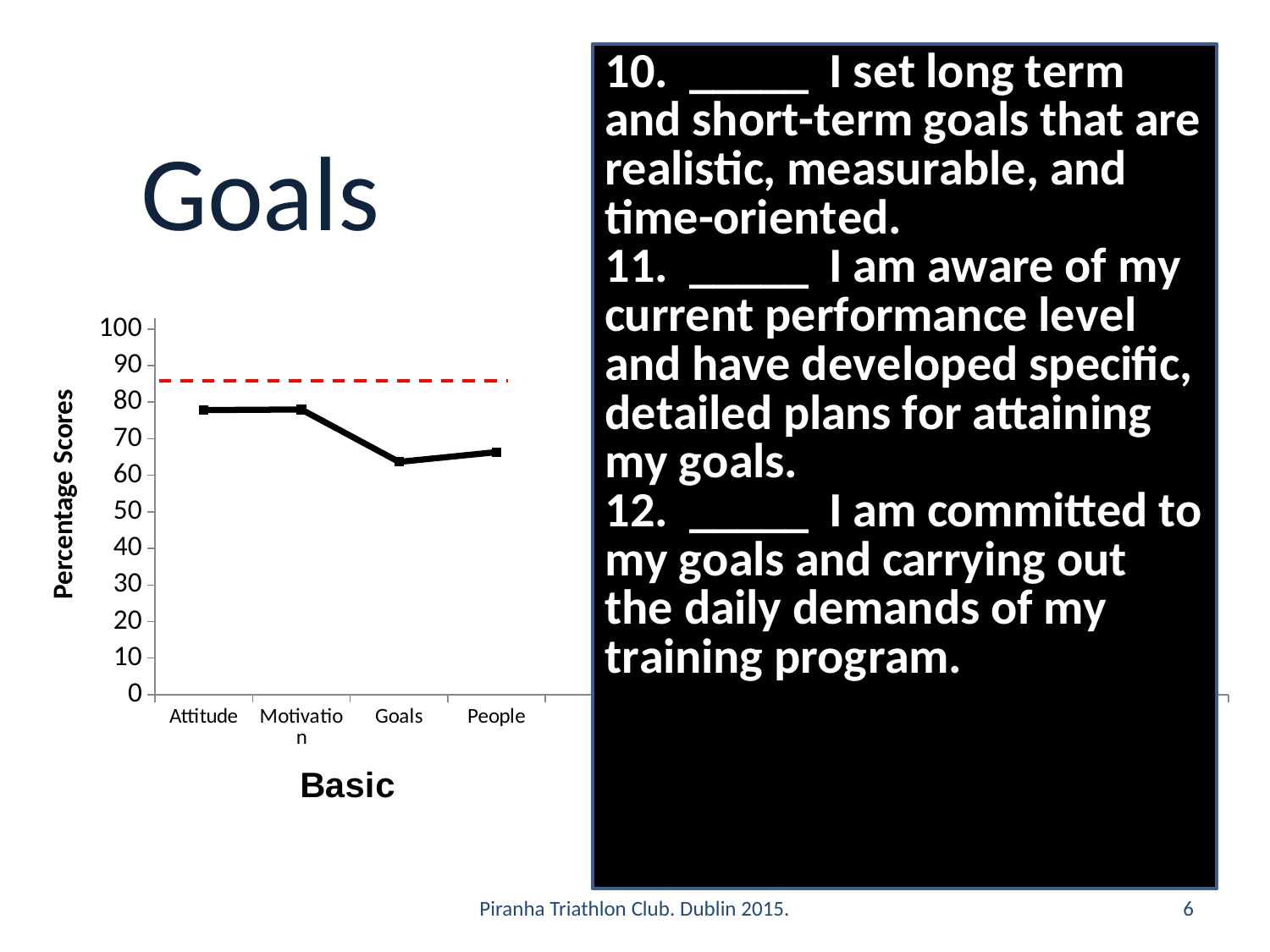
Is the value for Attitude greater or less than 80? less Is the value for Goals greater or less than 70? less What is the title of the vertical axis of the chart? Percentage Scores Is the value for Goals greater or less than 60? greater Which is larger, the value for Attitude or the value for Goals? Attitude What is the title of the horizontal axis of the chart? Basic What kind of chart is shown on the slide? line chart Which is larger, the value for Motivation or the value for People? Motivation Does the line rise or fall between Motivation and Goals? fall